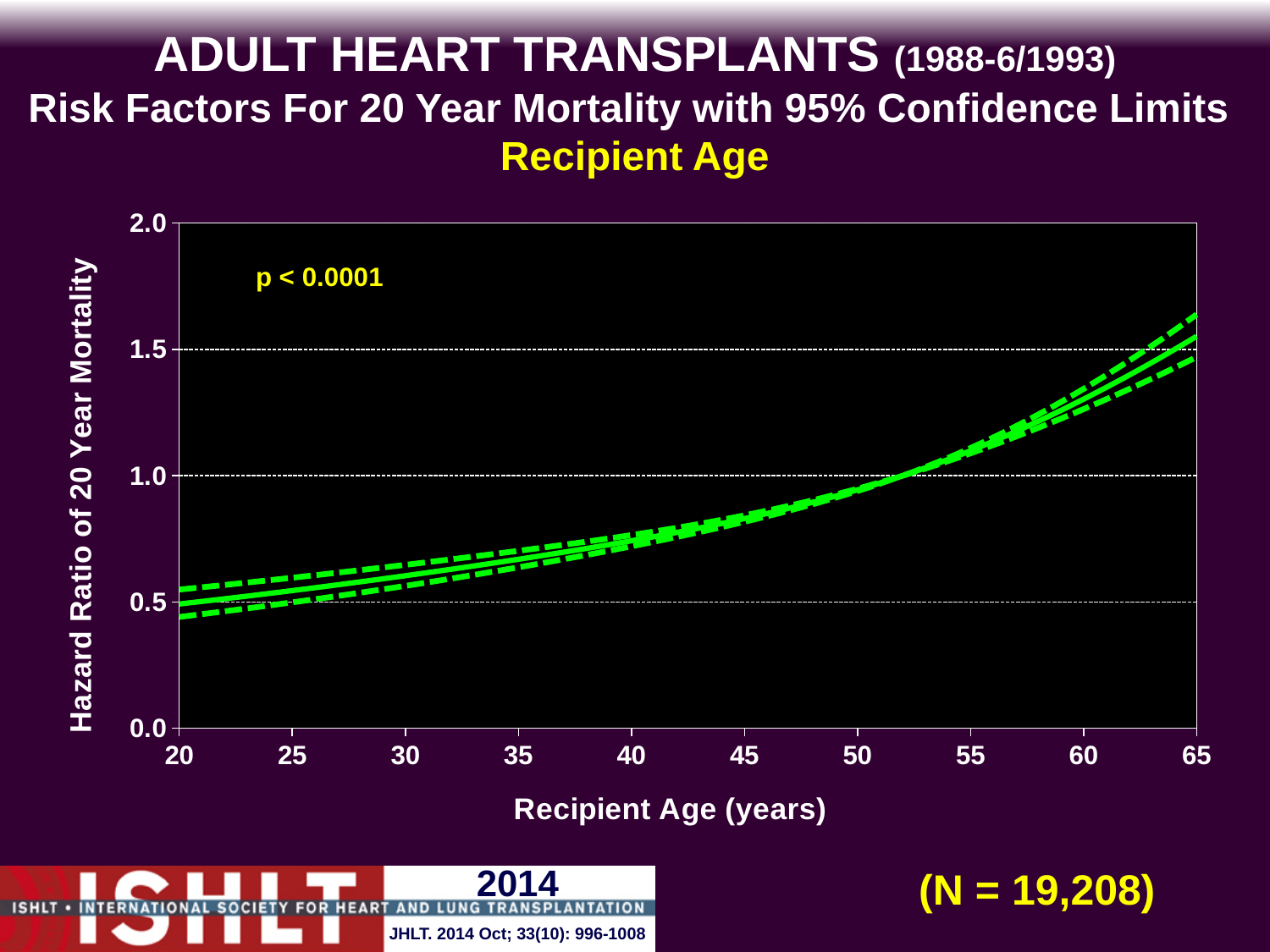
Is the hazard ratio for a recipient age of 40 years greater or less than 1.5? less At which recipient age shown on the x axis is the hazard ratio highest? 65 Is the hazard ratio for a recipient age of 20 years greater or less than 1.0? less Which is larger, the hazard ratio at recipient age 55 or at recipient age 35? 55 Is the hazard ratio for a recipient age of 65 years greater or less than 1.0? greater What p-value is printed on the chart? p < 0.0001 What is the label of the x axis? Recipient Age (years) What kind of chart is shown on the slide? line chart Does the hazard ratio of 20 year mortality rise or fall as recipient age increases from 20 to 65 years? rise At which recipient age shown on the x axis is the hazard ratio lowest? 20